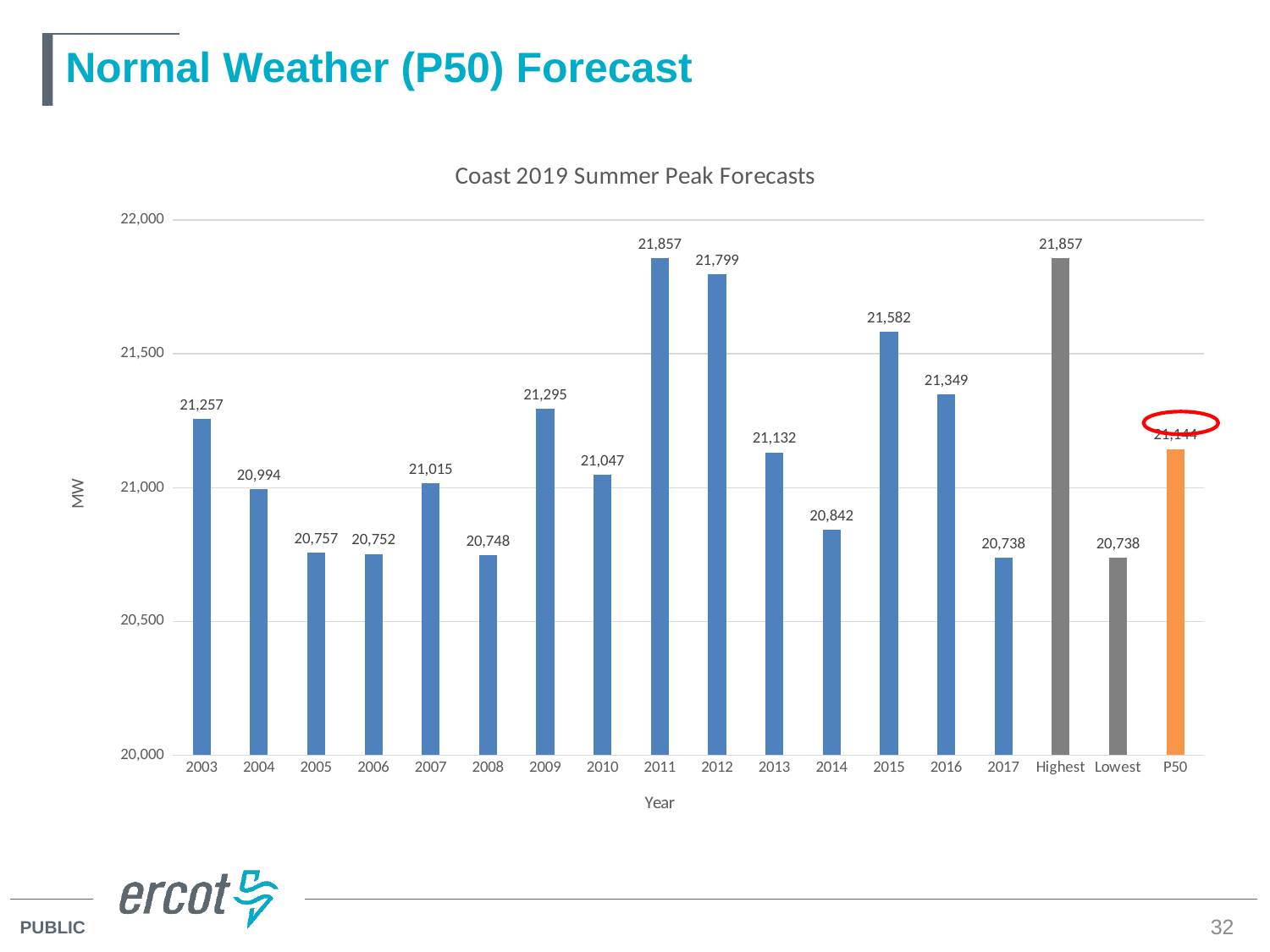
Which is larger, the value for 2003 or the value for 2009? 2009 What kind of chart is shown on the slide? bar chart Which year from 2003 to 2017 has the lowest forecast value? 2017 Is the value for 2014 greater or less than 21,000? less What is the difference between the values for 2015 and 2016? 233 What is the value for 2015? 21,582 Which year from 2003 to 2017 has the highest forecast value? 2011 How many bars are plotted in the chart? 18 What is the value for 2011 in the Coast 2019 Summer Peak Forecasts chart? 21,857 What is the label on the vertical axis of the chart? MW What is the difference between the values for 2011 and 2012? 58 What is the value shown for the Lowest bar? 20,738